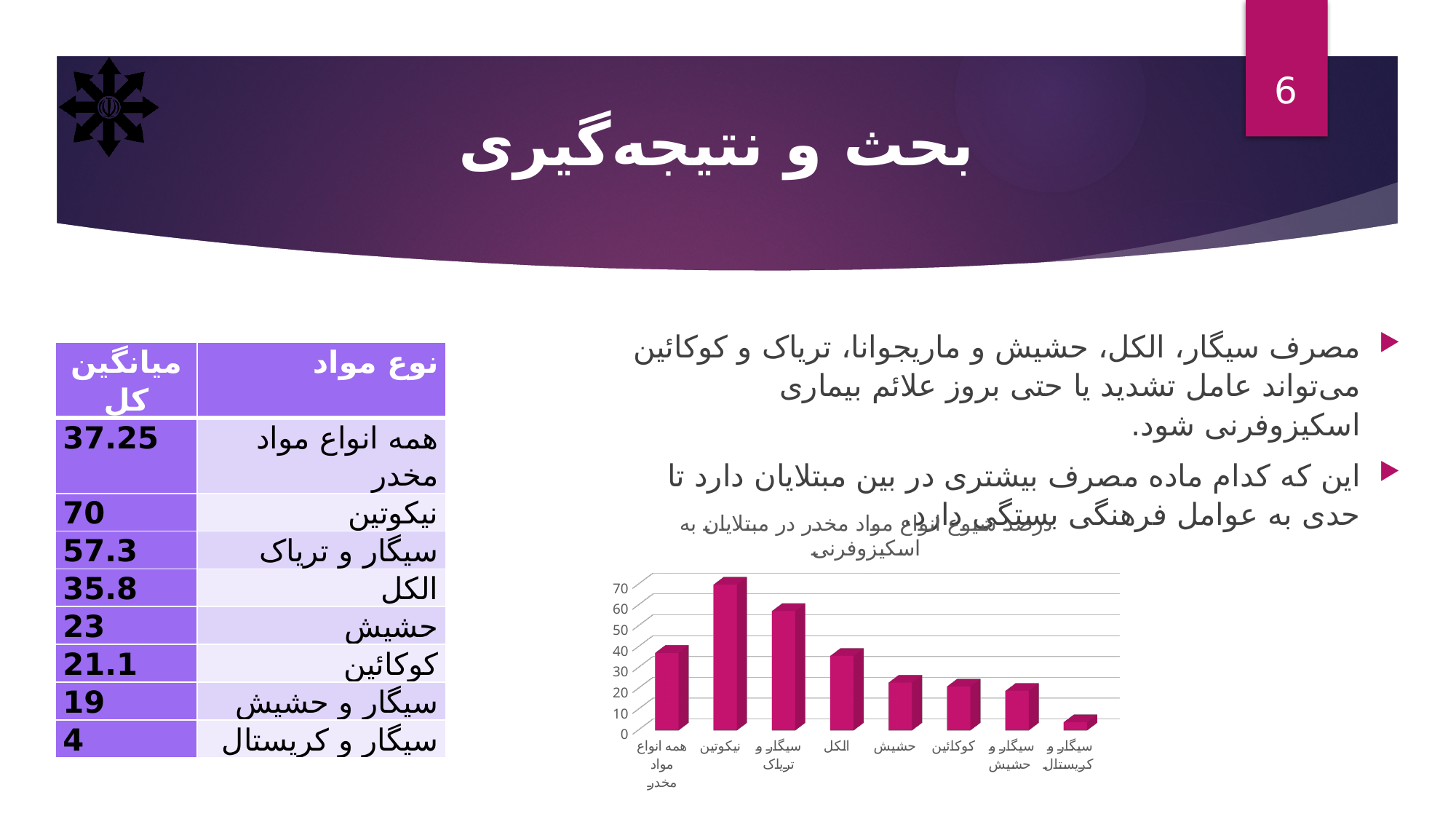
Is the value for حشیش greater or less than 20? greater What kind of chart is shown on the slide? bar chart Which category has the highest bar in the chart? نیکوتین Is the value for الکل greater or less than 40? less What is the value for نیکوتین in the chart? 70 What is the value for سیگار و تریاک according to the slide? 57.3 What is the difference between the values for نیکوتین and سیگار و کریستال? 66 What is the value for سیگار و کریستال according to the slide? 4 Which is larger, the bar for سیگار و تریاک or the bar for الکل? سیگار و تریاک How many categories are plotted in the bar chart? 8 Which category has the lowest bar in the chart? سیگار و کریستال From نیکوتین onward, do the bar values rise or fall along the x axis? fall